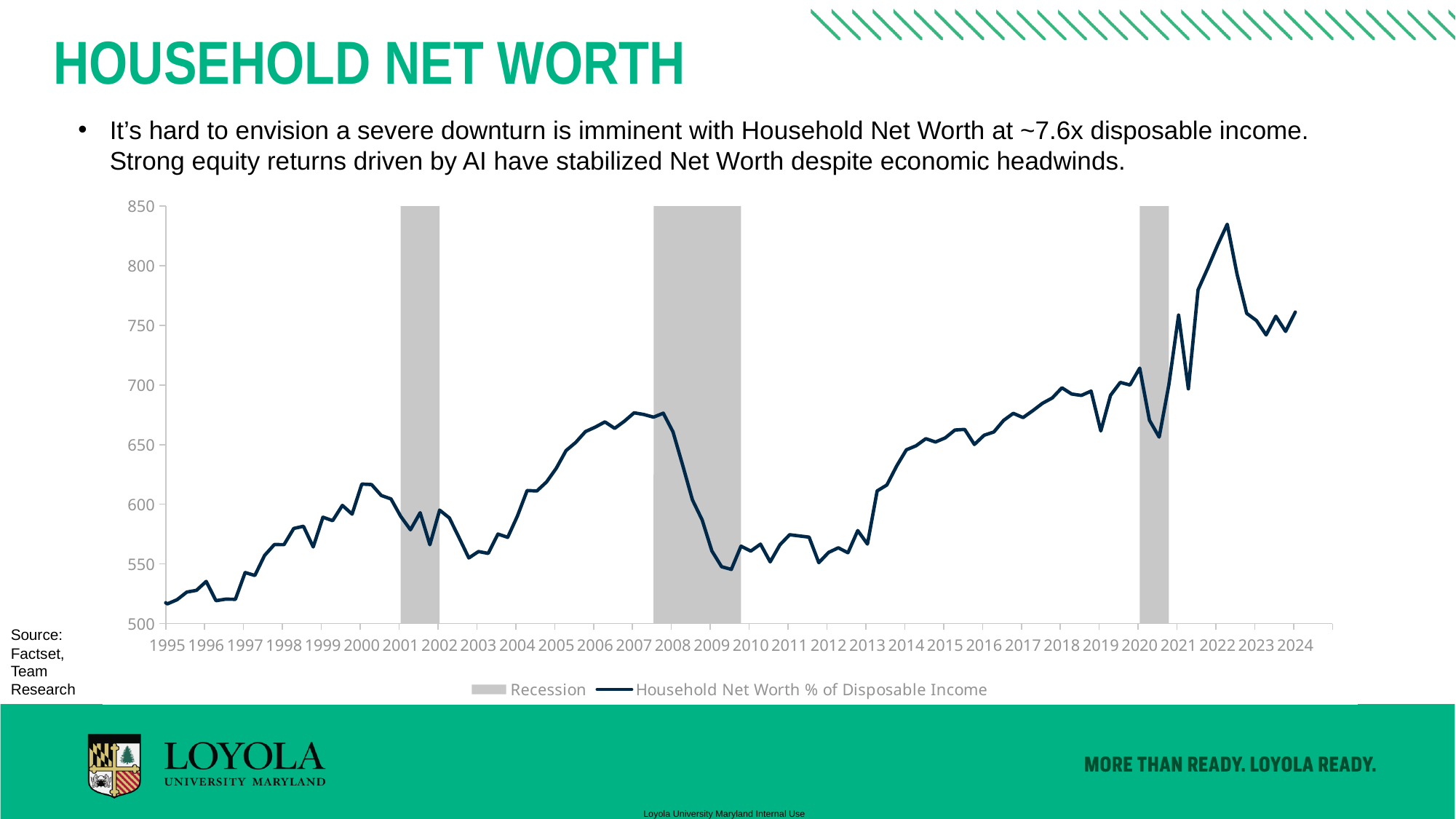
In which year does the Household Net Worth % of Disposable Income line reach its highest point? 2022 How many entries does the chart legend list? 2 Which is larger, the value of Household Net Worth % of Disposable Income in 2022 or in 2009? 2022 Is the peak value of Household Net Worth % of Disposable Income around 2022 greater or less than 800? greater What is the name of the line series in the legend? Household Net Worth % of Disposable Income Does the Household Net Worth % of Disposable Income line rise or fall between 2007 and 2009? fall Is the value for Household Net Worth % of Disposable Income at the end of 2024 greater or less than 700? greater What kind of chart is shown on the slide? line chart How many recession bands are shaded on the chart? 3 Is the value for Household Net Worth % of Disposable Income in 2009 greater or less than 600? less What do the grey shaded bands on the chart represent? Recession